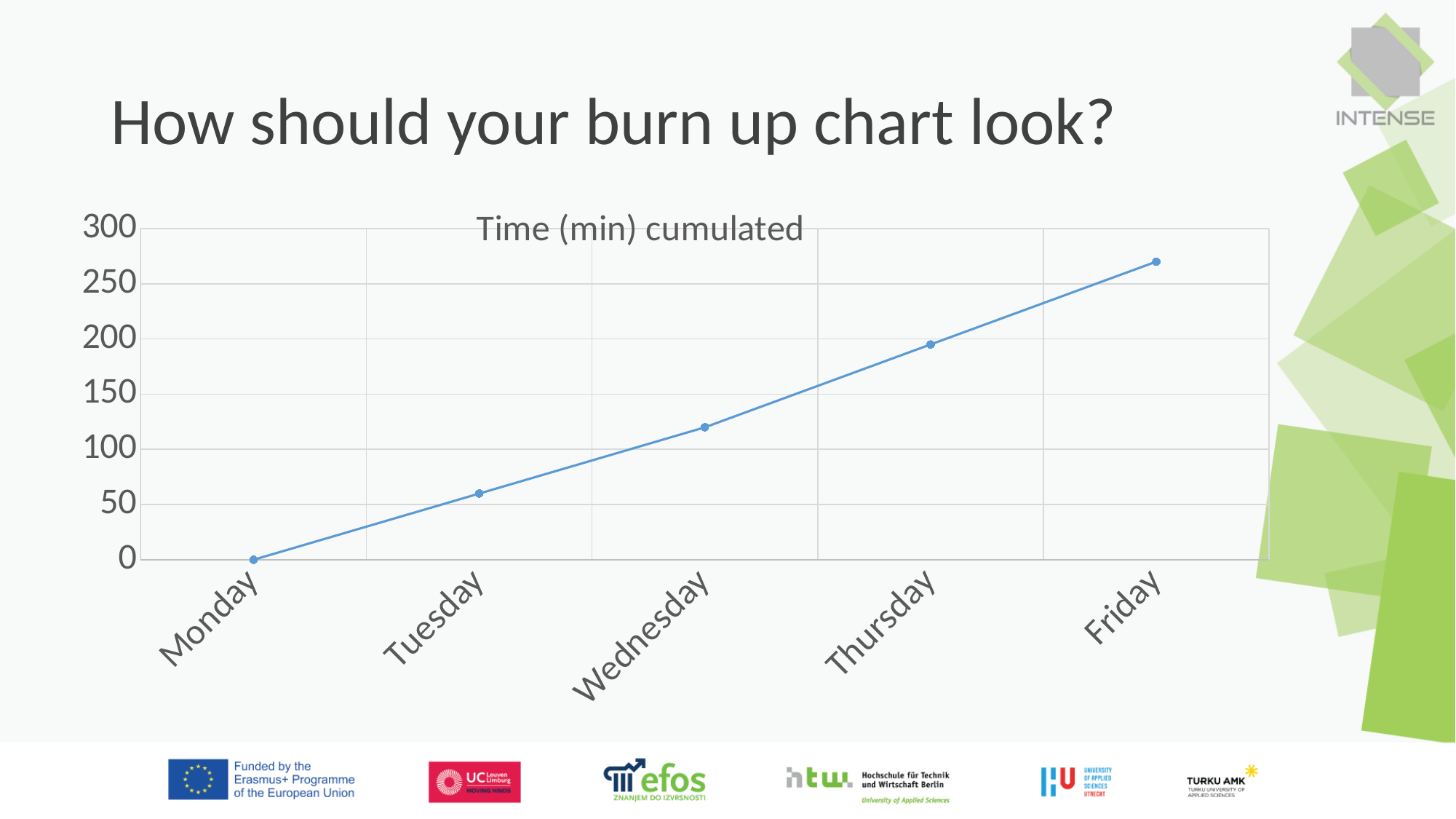
Is the value for Thursday greater or less than 150? greater Is the value for Wednesday greater or less than 100? greater What is the title of the chart? Time (min) cumulated Is the value for Tuesday greater or less than 50? greater What is the cumulated time value for Monday? 0 Do the values rise or fall from Monday to Friday? rise How many days are plotted on the x axis of the chart? 5 Which day has the highest cumulated time? Friday Which day has the lowest cumulated time? Monday What kind of chart is shown on the slide? line chart Which is larger, the value for Thursday or the value for Tuesday? Thursday